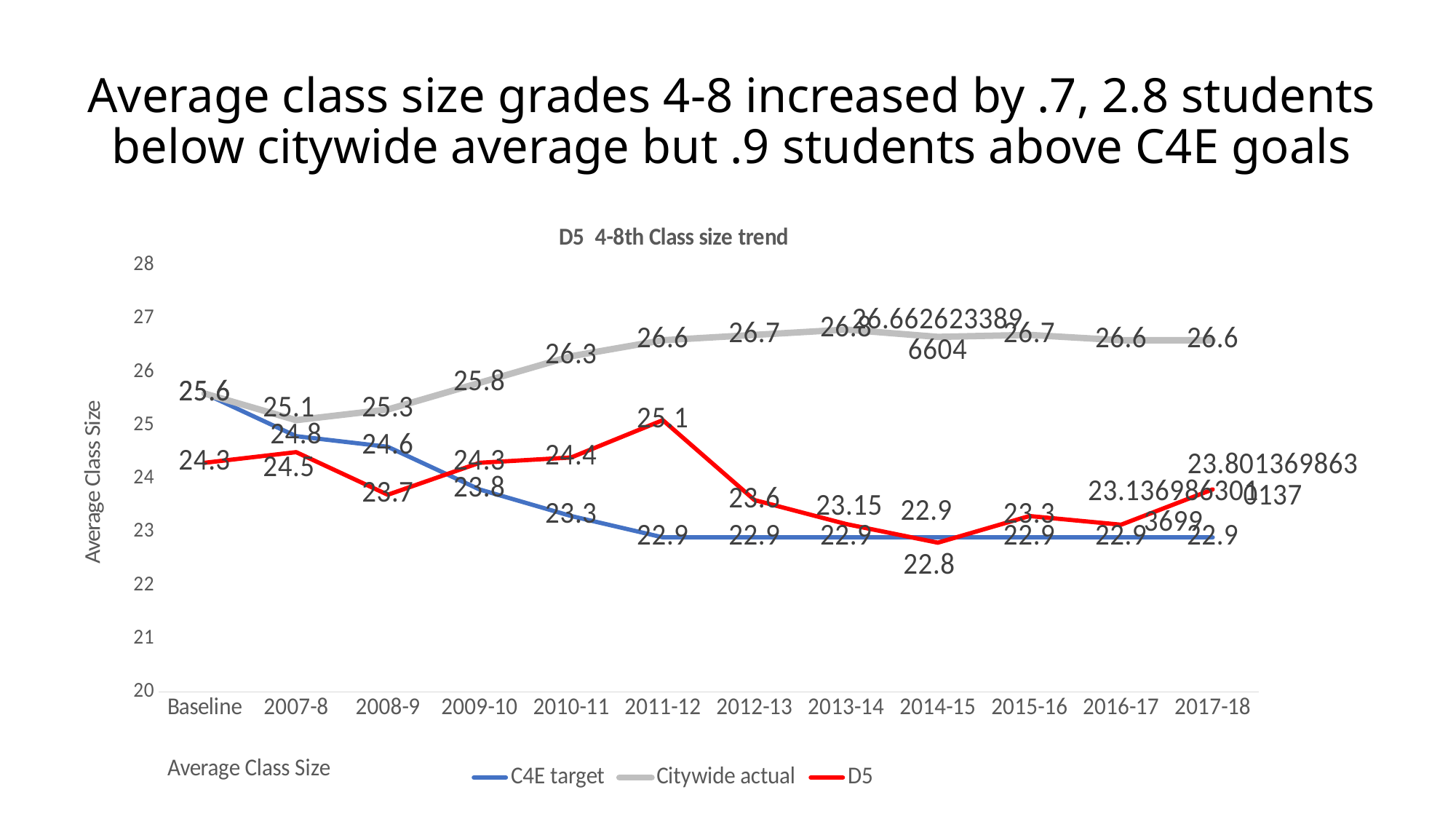
How many categories are shown on the x axis? 12 What is the C4E target value for 2009-10? 23.8 In which year does the D5 series reach its highest value? 2011-12 What is the D5 value for 2014-15? 22.8 How many series does the legend list? 3 What is the D5 value for 2011-12? 25.1 What is the D5 value for 2013-14? 23.15 In 2008-9, which is larger: the D5 value or the C4E target value? C4E target What kind of chart is shown on the slide? line chart In which year does the D5 series reach its lowest value? 2014-15 What is the difference between the Citywide actual and D5 values in 2012-13? 3.1 What is the Citywide actual value for 2010-11? 26.3